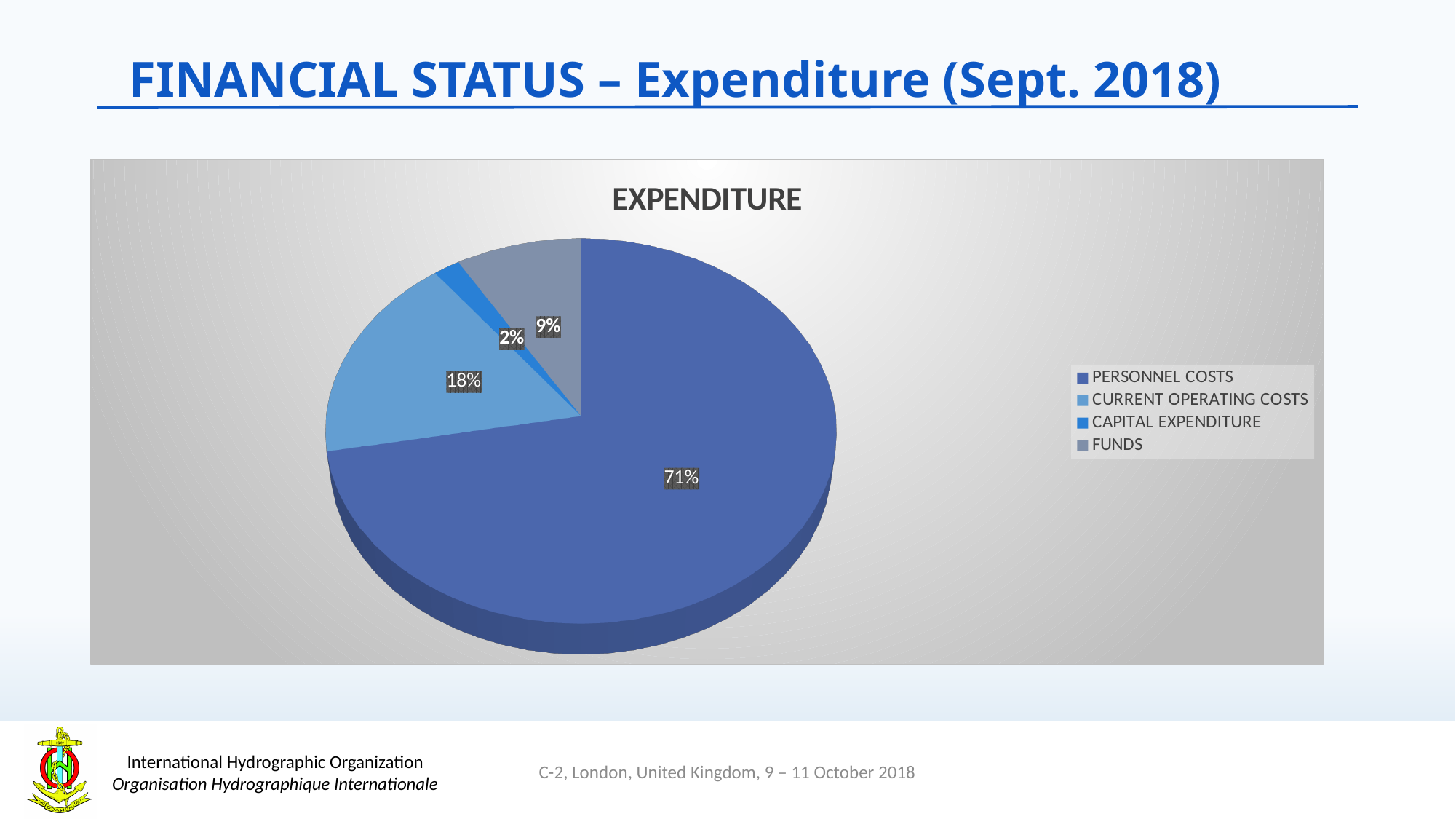
What share of expenditure is Current Operating Costs? 18% Which is larger, the share for Funds or the share for Capital Expenditure? Funds What share of expenditure is Capital Expenditure? 2% Which legend entry is listed last? FUNDS What share of expenditure is Personnel Costs? 71% What share of expenditure is Funds? 9% What is the difference in percentage points between Personnel Costs and Current Operating Costs? 53 Which category has the smallest share of expenditure? Capital Expenditure What is the title of the chart? EXPENDITURE What kind of chart is shown on the slide? Pie chart Which category has the largest share of expenditure? Personnel Costs How many categories does the pie chart show? 4